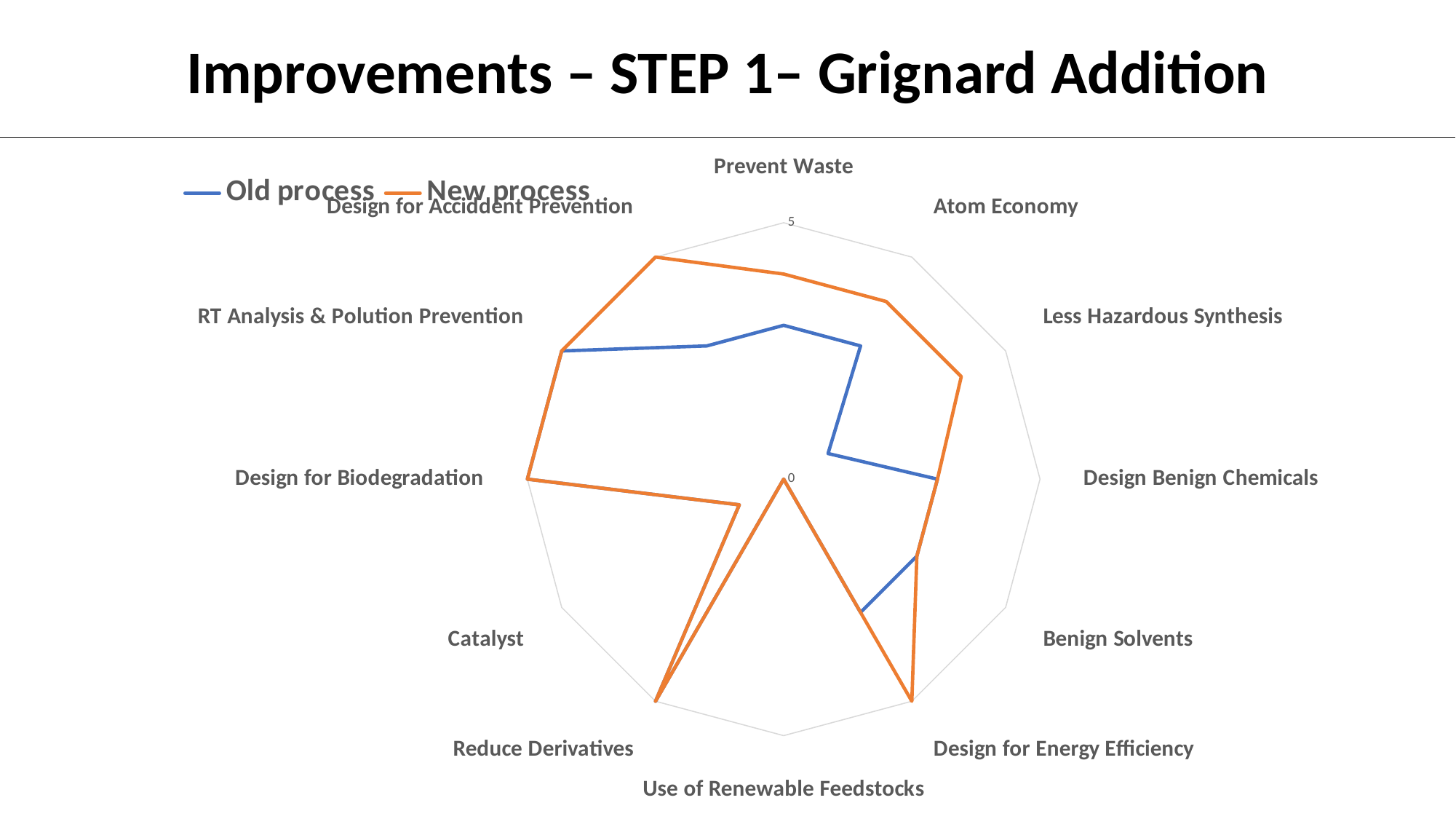
How many series does the legend list? 2 What are the two series named in the legend? Old process and New process What kind of chart is shown on the slide? Radar chart What is the maximum value shown on the chart's axis scale? 5 At Prevent Waste, which series has the larger value, Old process or New process? New process At Less Hazardous Synthesis, which series has the larger value, Old process or New process? New process What is the value for New process at Reduce Derivatives? 5 What is the value for New process at Use of Renewable Feedstocks? 0 What is the value for New process at Design for Energy Efficiency? 5 How many categories (axes) does the radar chart have? 12 At Design for Acciddent Prevention, which series has the larger value, Old process or New process? New process Is the value for Old process at Less Hazardous Synthesis greater or less than 5? less